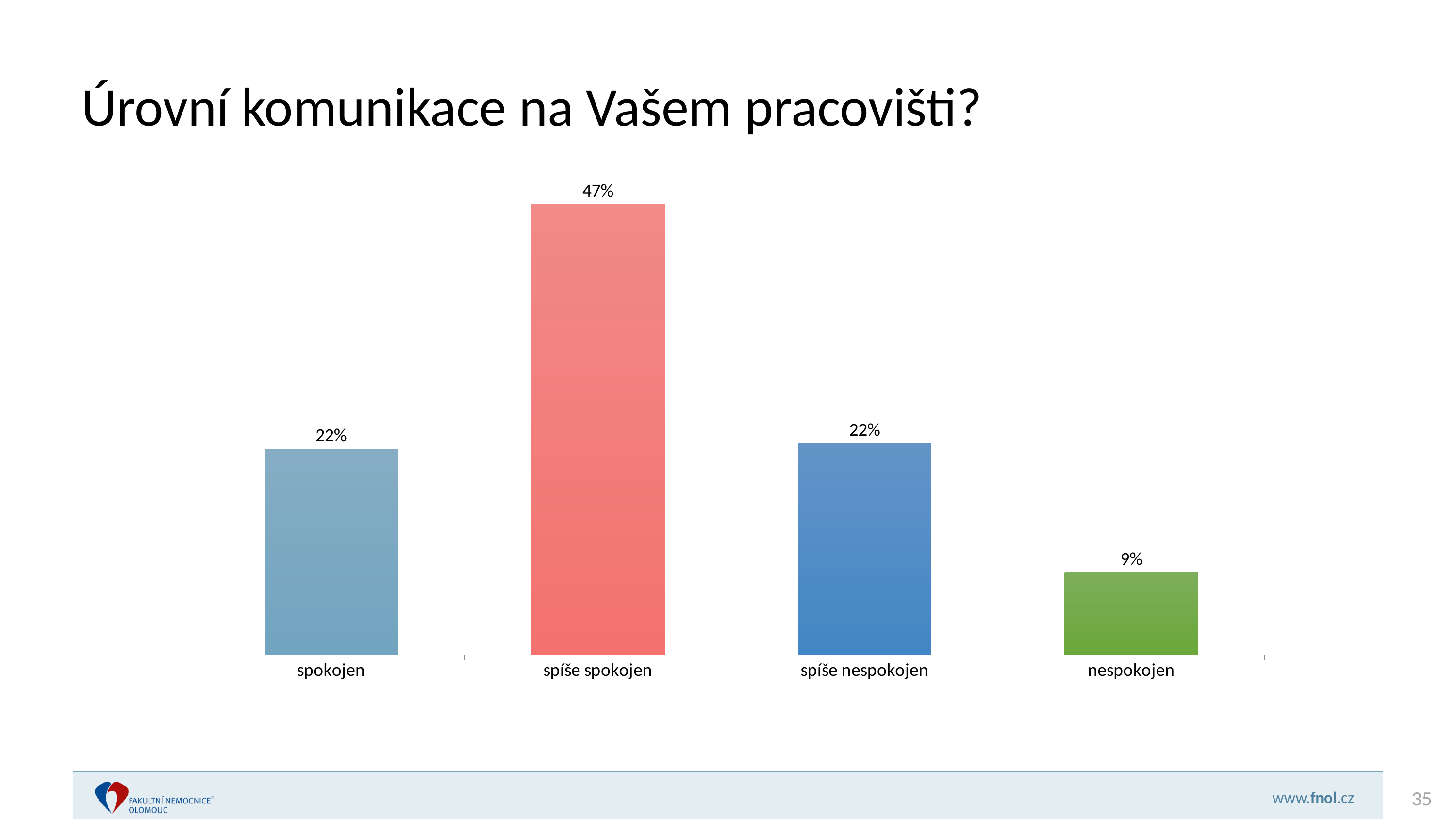
What is the value for "nespokojen"? 9% What is the value for "spokojen"? 22% What kind of chart is shown on the slide? bar chart Which category has the highest value? spíše spokojen What is the difference between the values for "spíše spokojen" and "nespokojen"? 38% Which is larger, the value for "spíše nespokojen" or the value for "nespokojen"? spíše nespokojen What is the value for "spíše spokojen"? 47% How many categories are shown in the chart? 4 What is the difference between the values for "spíše spokojen" and "spokojen"? 25% Which category has the lowest value? nespokojen What is the title of the slide containing the chart? Úrovní komunikace na Vašem pracovišti? What is the value for "spíše nespokojen"? 22%